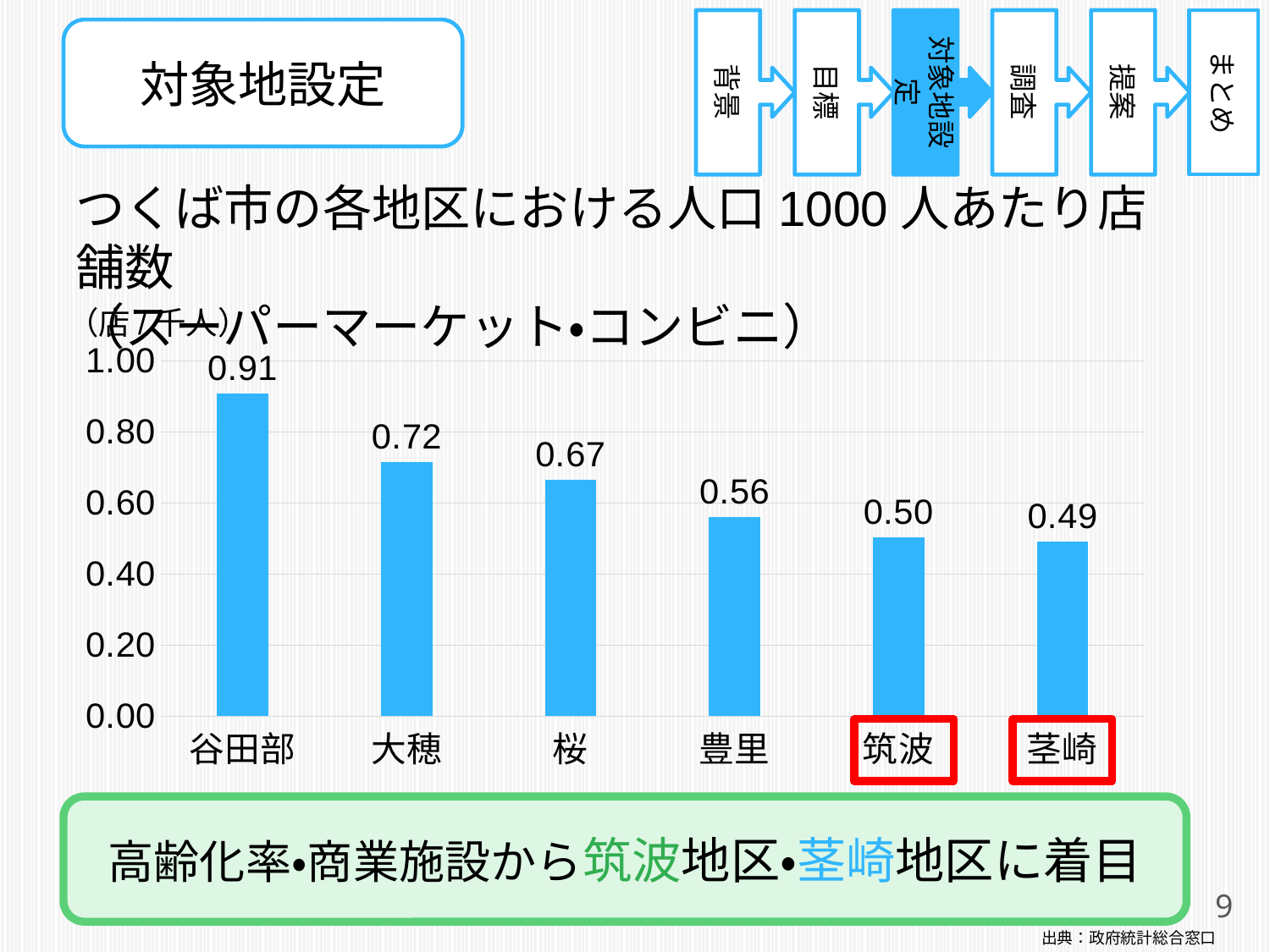
Do the values rise or fall from left to right across the districts? fall What is the value for 谷田部? 0.91 What kind of chart is shown on the slide? bar chart Which is larger, the value for 大穂 or the value for 豊里? 大穂 What is the value for 大穂? 0.72 What is the value for 豊里? 0.56 Which district has the highest value? 谷田部 Which district has the lowest value? 茎崎 What is the value for 茎崎? 0.49 What is the difference between the values for 谷田部 and 筑波? 0.41 How many districts are shown in the chart? 6 What is the value for 桜? 0.67